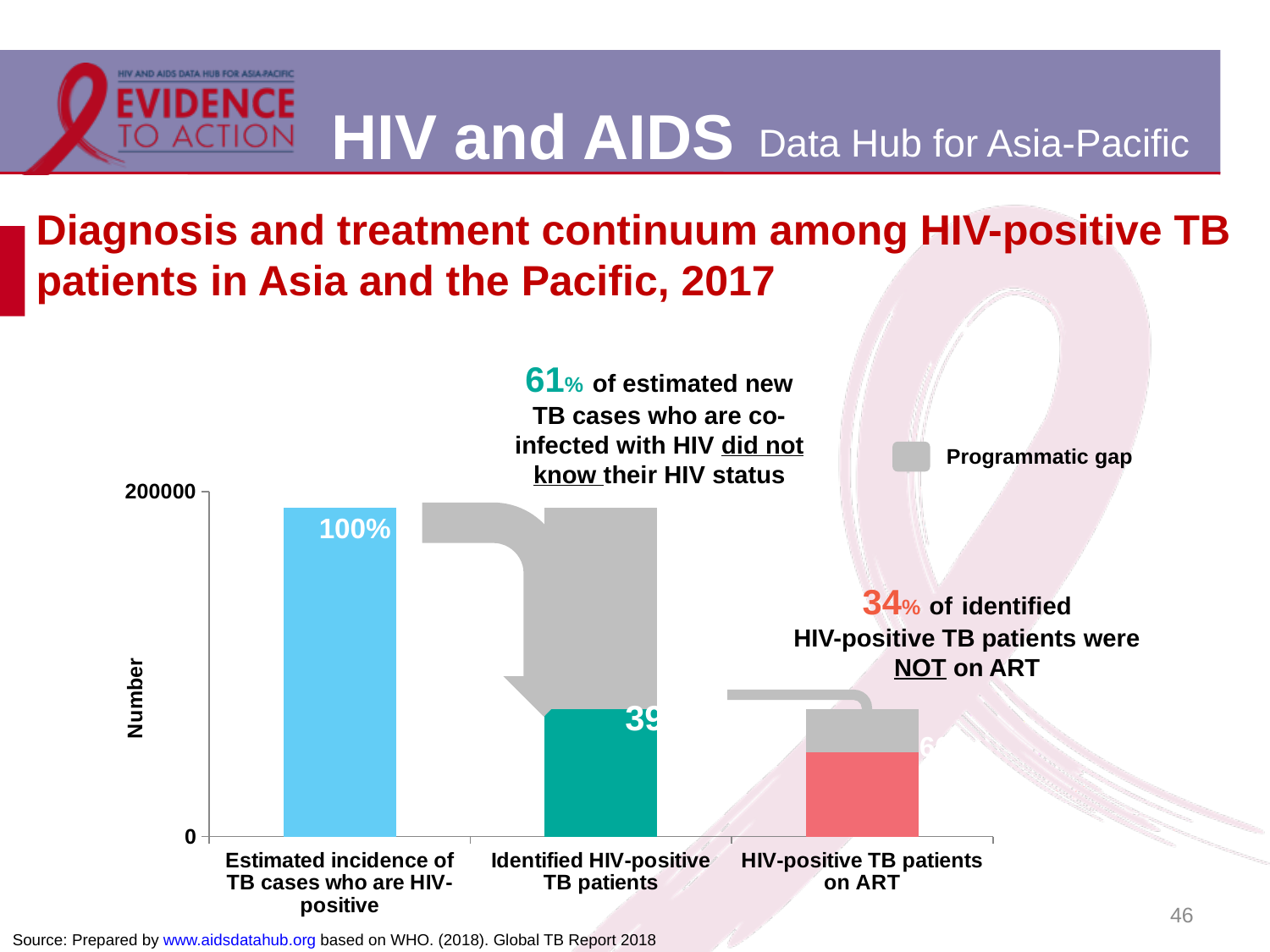
According to the annotation on the chart, what percentage of identified HIV-positive TB patients were NOT on ART? 34% How many categories are plotted on the x axis of the chart? 3 Is the value for HIV-positive TB patients on ART greater or less than 200000? less What kind of chart is shown on the slide? Bar chart What does the grey colour in the chart legend represent? Programmatic gap What is the title of the y axis of the chart? Number Which category has the lowest bar in the chart? HIV-positive TB patients on ART Which category has the highest bar in the chart? Estimated incidence of TB cases who are HIV-positive Do the bar values rise or fall moving from left to right along the x axis? fall Which is larger: the bar for Identified HIV-positive TB patients or the bar for HIV-positive TB patients on ART? Identified HIV-positive TB patients Is the value for Identified HIV-positive TB patients greater or less than 200000? less What percentage label is shown on the bar for Estimated incidence of TB cases who are HIV-positive? 100%